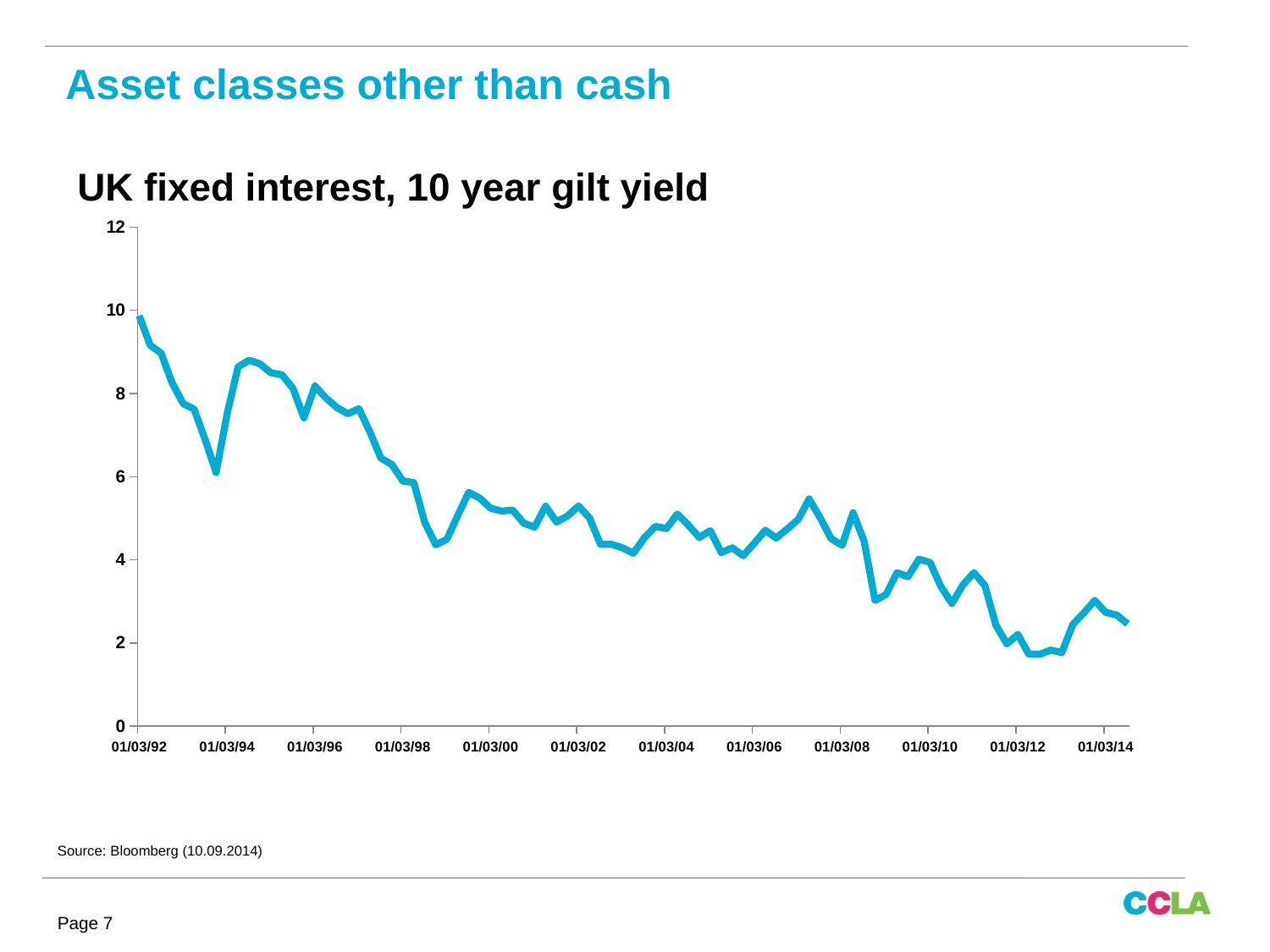
What kind of chart is shown on the slide? Line chart Is the value at 01/03/12 greater or less than 4? less Is the value at 01/03/96 greater or less than 6? greater Is the value at 01/03/92 greater or less than 8? greater Overall, does the 10 year gilt yield rise or fall from 01/03/92 to 01/03/14? Fall Which is larger, the value at 01/03/96 or the value at 01/03/06? 01/03/96 What is the title of the chart? UK fixed interest, 10 year gilt yield Which is larger, the value at 01/03/92 or the value at 01/03/14? 01/03/92 At which labelled date on the x axis is the yield highest? 01/03/92 What is the source given for the chart data? Bloomberg (10.09.2014)